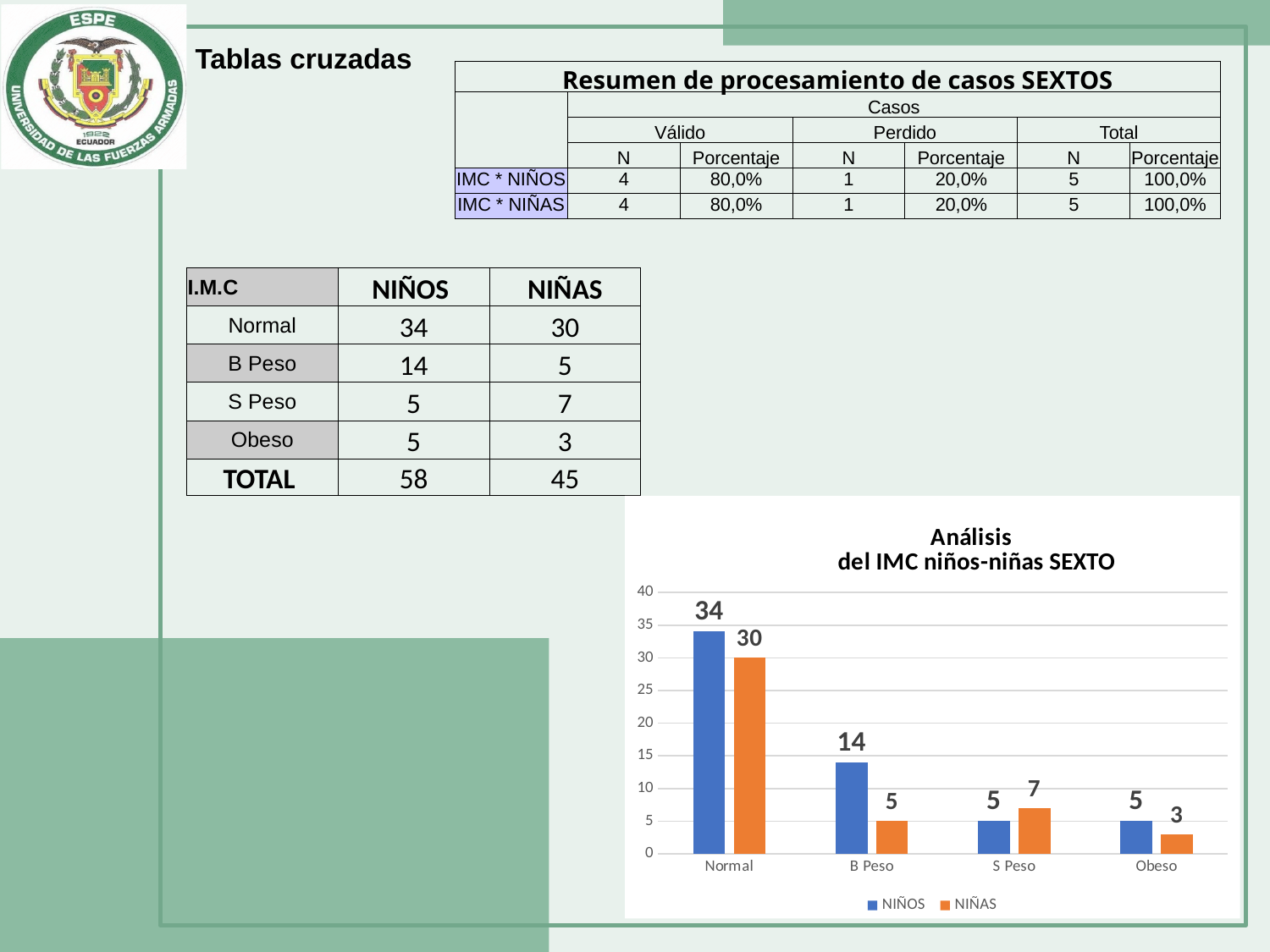
What is the difference between NIÑOS and NIÑAS in the B Peso category? 9 How many series does the chart legend list? 2 What is the value for NIÑOS in the Normal category? 34 How many categories are shown on the x axis of the chart? 4 What is the value for NIÑAS in the S Peso category? 7 In the S Peso category, which series has the larger value, NIÑOS or NIÑAS? NIÑAS What type of chart is shown on the slide? bar chart What is the value for NIÑAS in the Obeso category? 3 Which category has the highest value for NIÑOS? Normal What is the title of the chart? Análisis del IMC niños-niñas SEXTO Which category has the lowest value for NIÑAS? Obeso Is the value for NIÑAS in the Normal category greater or less than 25? greater